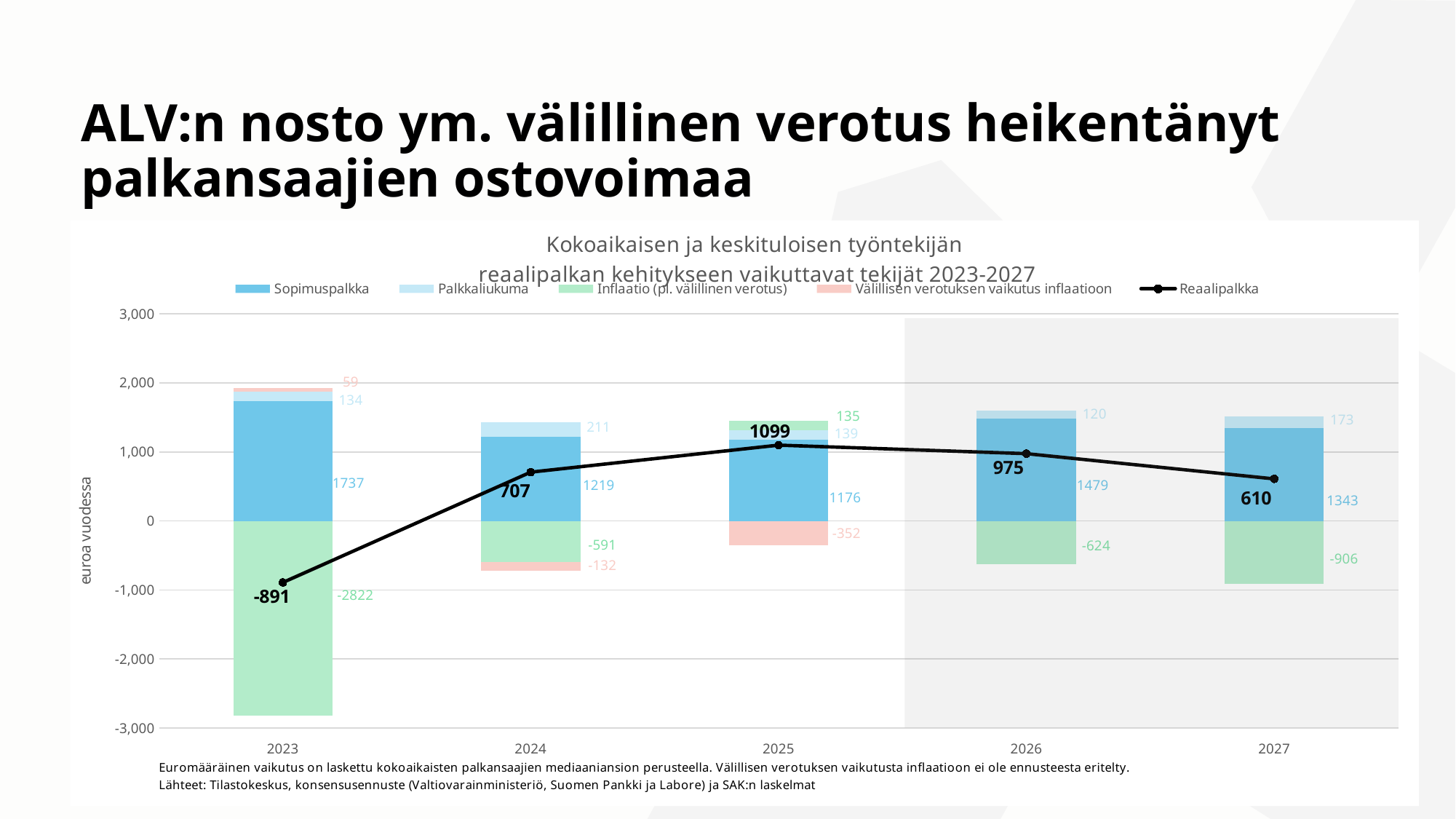
What is the Sopimuspalkka value for 2023? 1737 In which year is the Reaalipalkka value highest? 2025 What is the Palkkaliukuma value for 2024? 211 What is the difference between the Sopimuspalkka values for 2026 and 2027? 136 How many years are shown on the x axis? 5 Does the Reaalipalkka line rise or fall from 2025 to 2027? fall What is the Välillisen verotuksen vaikutus inflaatioon value for 2025? -352 Which is larger, the Reaalipalkka value for 2024 or for 2026? 2026 In which year is the Reaalipalkka value lowest? 2023 What is the Reaalipalkka value for 2025? 1099 What is the Inflaatio (pl. välillinen verotus) value for 2027? -906 How many series does the legend list? 5